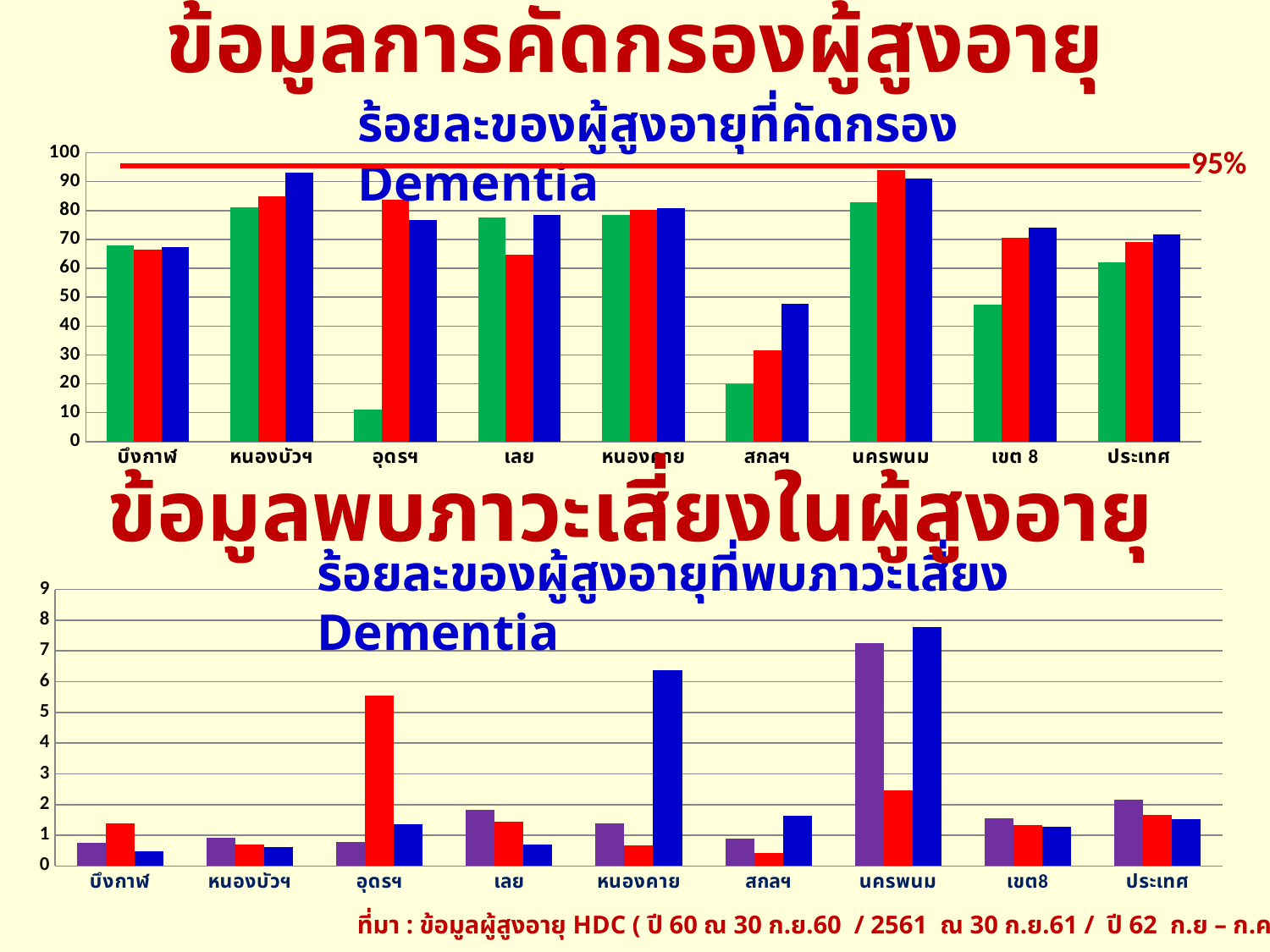
In the top chart, is the green bar for อุดรฯ greater or less than 20? less In the top chart, how many categories are shown on the x axis? 9 In the top chart, which is larger: the blue bar for หนองบัวฯ or the blue bar for บึงกาฬ? หนองบัวฯ In the bottom chart, which category has the highest blue bar? นครพนม In the top chart, which category has the lowest green bar? อุดรฯ What kind of chart is the top chart (ร้อยละของผู้สูงอายุที่คัดกรอง Dementia)? bar chart In the bottom chart, which is larger: the red bar for อุดรฯ or the red bar for เลย? อุดรฯ In the top chart, what value does the red horizontal reference line mark? 95% In the top chart, is the red bar for นครพนม greater or less than 90? greater In the bottom chart, is the red bar for อุดรฯ greater or less than 5? greater In the bottom chart, how many bars are plotted for each category? 3 What kind of chart is the bottom chart (ร้อยละของผู้สูงอายุที่พบภาวะเสี่ยง Dementia)? bar chart